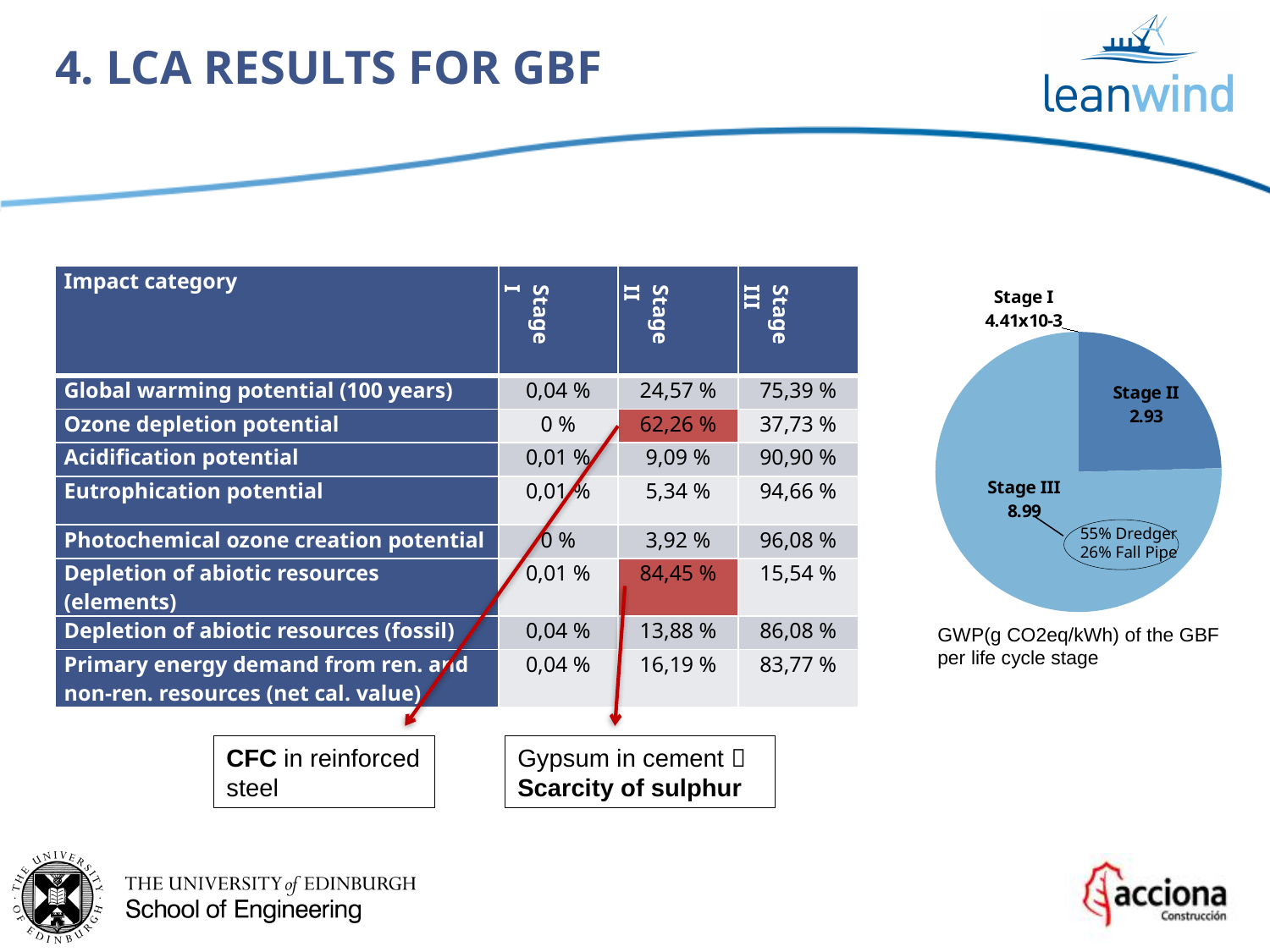
Which life cycle stage has the smallest slice in the pie chart? Stage I In the pie chart, which has a larger GWP value, Stage II or Stage III? Stage III Which life cycle stage has the largest slice in the pie chart? Stage III What is the GWP value shown for Stage I in the pie chart? 4.41x10-3 What is the GWP value shown for Stage III in the pie chart? 8.99 In the pie chart, what is the difference between the GWP values of Stage III and Stage II? 6.06 According to the annotation on the pie chart, what percentage of Stage III is attributed to the Dredger? 55% What type of chart is used to show the GWP of the GBF per life cycle stage? Pie chart How many life cycle stages are shown in the pie chart? 3 What unit is given in the caption of the pie chart for GWP? g CO2eq/kWh What is the GWP value shown for Stage II in the pie chart? 2.93